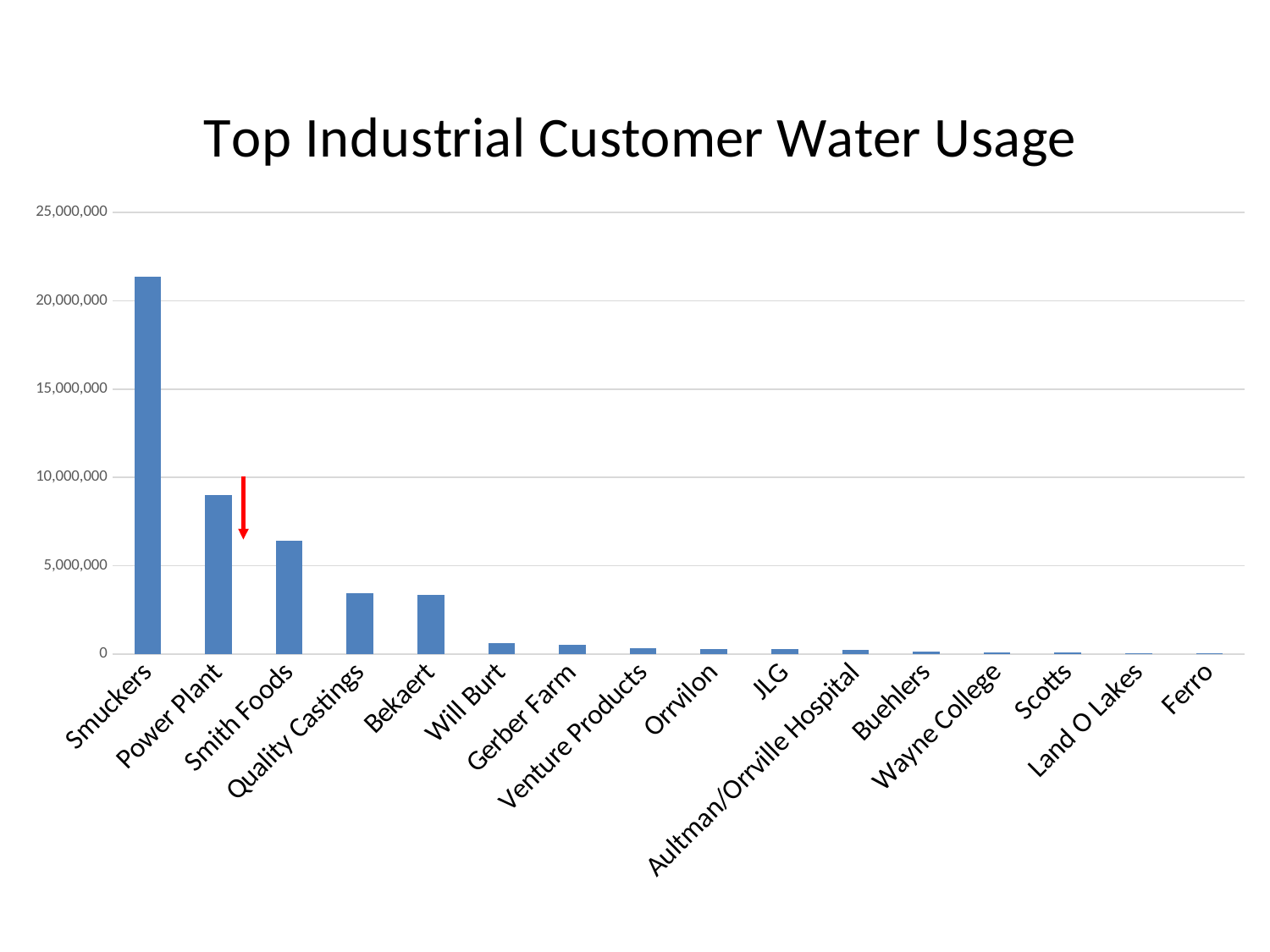
Is the value for Smith Foods greater or less than 5,000,000? greater Which customer has the highest water usage? Smuckers How many customers are shown on the x axis? 16 Which has the larger water usage, Smuckers or Power Plant? Smuckers Which customer's bar does the red arrow point to? Power Plant What kind of chart is shown on the slide? bar chart What is the title of the chart? Top Industrial Customer Water Usage Do the values rise or fall moving from left to right along the x axis? fall Which has the larger water usage, Smith Foods or Will Burt? Smith Foods Is the value for Quality Castings greater or less than 5,000,000? less Is the value for Smuckers greater or less than 20,000,000? greater